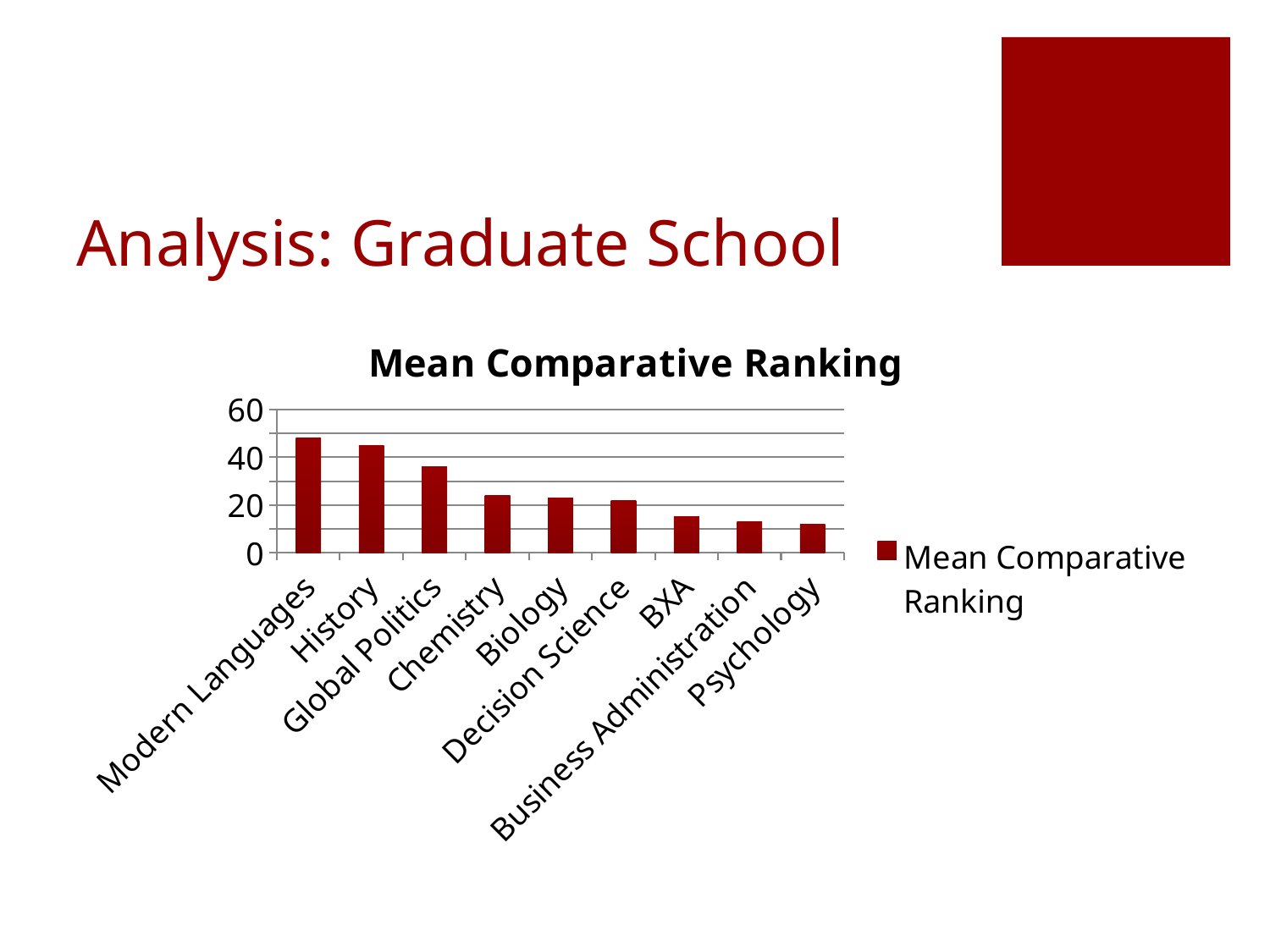
Is the value for Chemistry greater or less than 20? greater How many series does the legend list? 1 Is the value for BXA greater or less than 20? less Do the values rise or fall moving from left to right along the x axis? fall Is the value for Global Politics greater or less than 40? less Which category has the highest Mean Comparative Ranking? Modern Languages How many categories are plotted in the Mean Comparative Ranking chart? 9 What kind of chart is shown on the slide? bar chart Which has a larger Mean Comparative Ranking, History or Chemistry? History What is the title of the chart? Mean Comparative Ranking